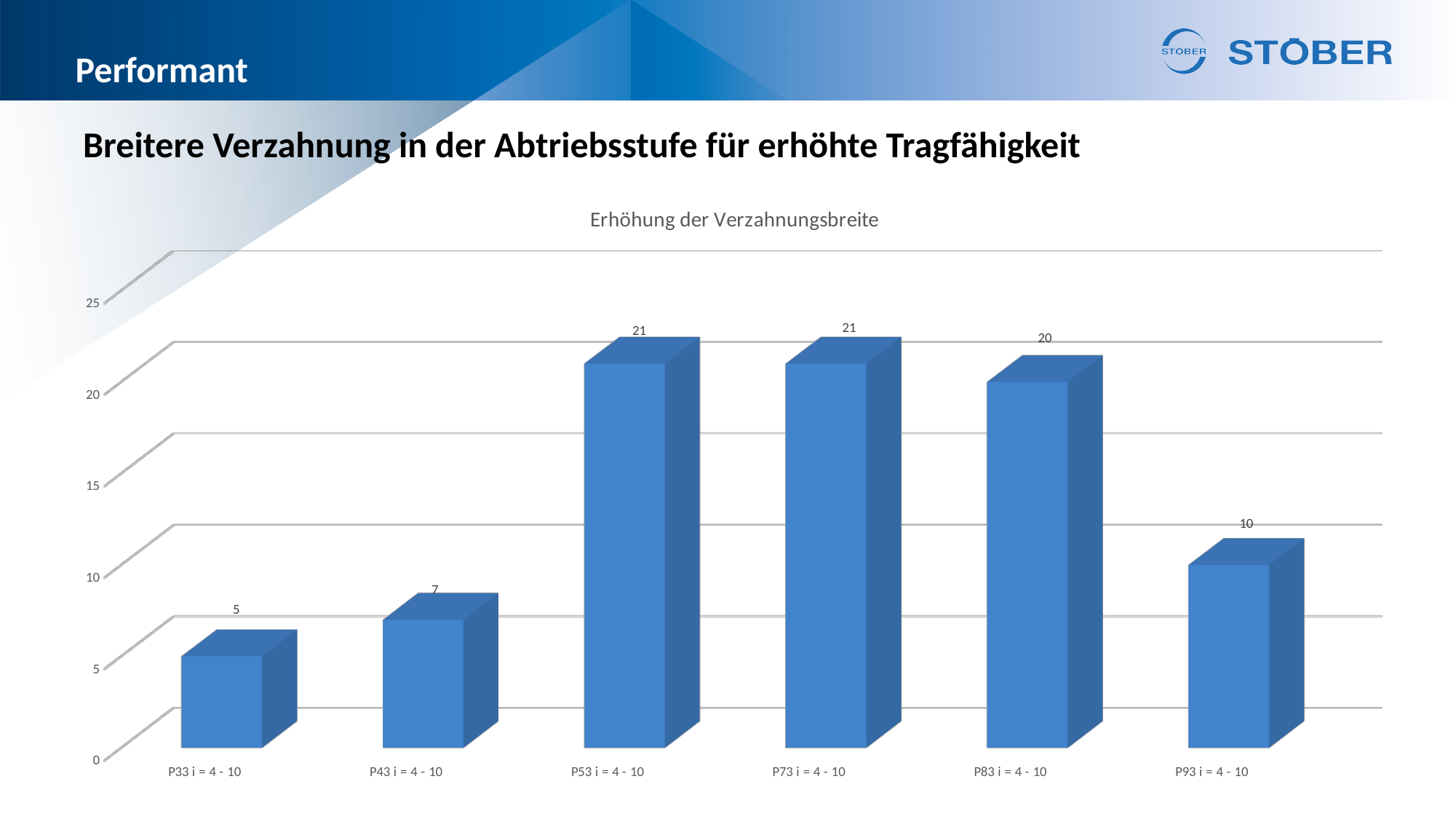
How many categories are shown on the x axis? 6 Is the value for P73 i = 4 - 10 greater or less than 15? greater What kind of chart is shown? bar chart Which category has the lowest value? P33 i = 4 - 10 Which is larger, the value for P43 i = 4 - 10 or the value for P93 i = 4 - 10? P93 i = 4 - 10 What is the value for P93 i = 4 - 10? 10 What is the title of the chart? Erhöhung der Verzahnungsbreite What is the difference between the values for P53 i = 4 - 10 and P43 i = 4 - 10? 14 What is the value for P83 i = 4 - 10? 20 What is the value for P33 i = 4 - 10? 5 What is the highest value shown on the vertical axis? 25 What is the difference between the values for P83 i = 4 - 10 and P93 i = 4 - 10? 10